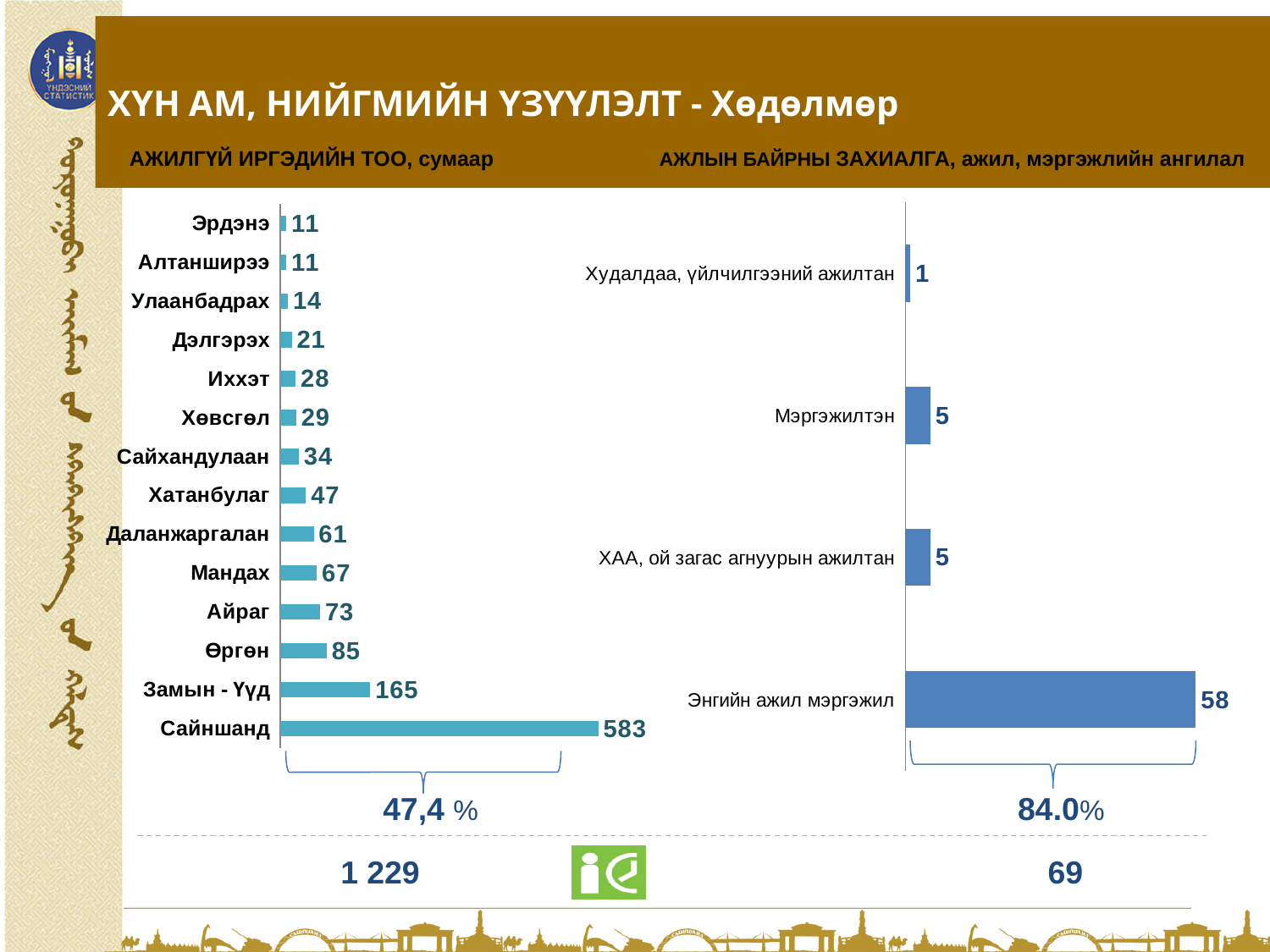
In the left chart (АЖИЛГҮЙ ИРГЭДИЙН ТОО, сумаар), which soum has the lowest value? Эрдэнэ and Алтанширээ (11 each) In the left chart (АЖИЛГҮЙ ИРГЭДИЙН ТОО, сумаар), what is the difference between Сайншанд and Замын - Үүд? 418 In the left chart (АЖИЛГҮЙ ИРГЭДИЙН ТОО, сумаар), which soum has the highest value? Сайншанд In the left chart (АЖИЛГҮЙ ИРГЭДИЙН ТОО, сумаар), what is the value for Сайншанд? 583 What type of chart is the right chart (АЖЛЫН БАЙРНЫ ЗАХИАЛГА)? Bar chart In the right chart (АЖЛЫН БАЙРНЫ ЗАХИАЛГА), what is the value for Энгийн ажил мэргэжил? 58 In the right chart (АЖЛЫН БАЙРНЫ ЗАХИАЛГА), what is the value for Худалдаа, үйлчилгээний ажилтан? 1 In the left chart (АЖИЛГҮЙ ИРГЭДИЙН ТОО, сумаар), which is larger, Айраг or Мандах? Айраг What percentage is shown below the right chart (АЖЛЫН БАЙРНЫ ЗАХИАЛГА) for the bracketed bar? 84.0% In the right chart (АЖЛЫН БАЙРНЫ ЗАХИАЛГА), how many categories are shown? 4 In the left chart (АЖИЛГҮЙ ИРГЭДИЙН ТОО, сумаар), what is the value for Замын - Үүд? 165 In the left chart (АЖИЛГҮЙ ИРГЭДИЙН ТОО, сумаар), how many soums are shown? 14